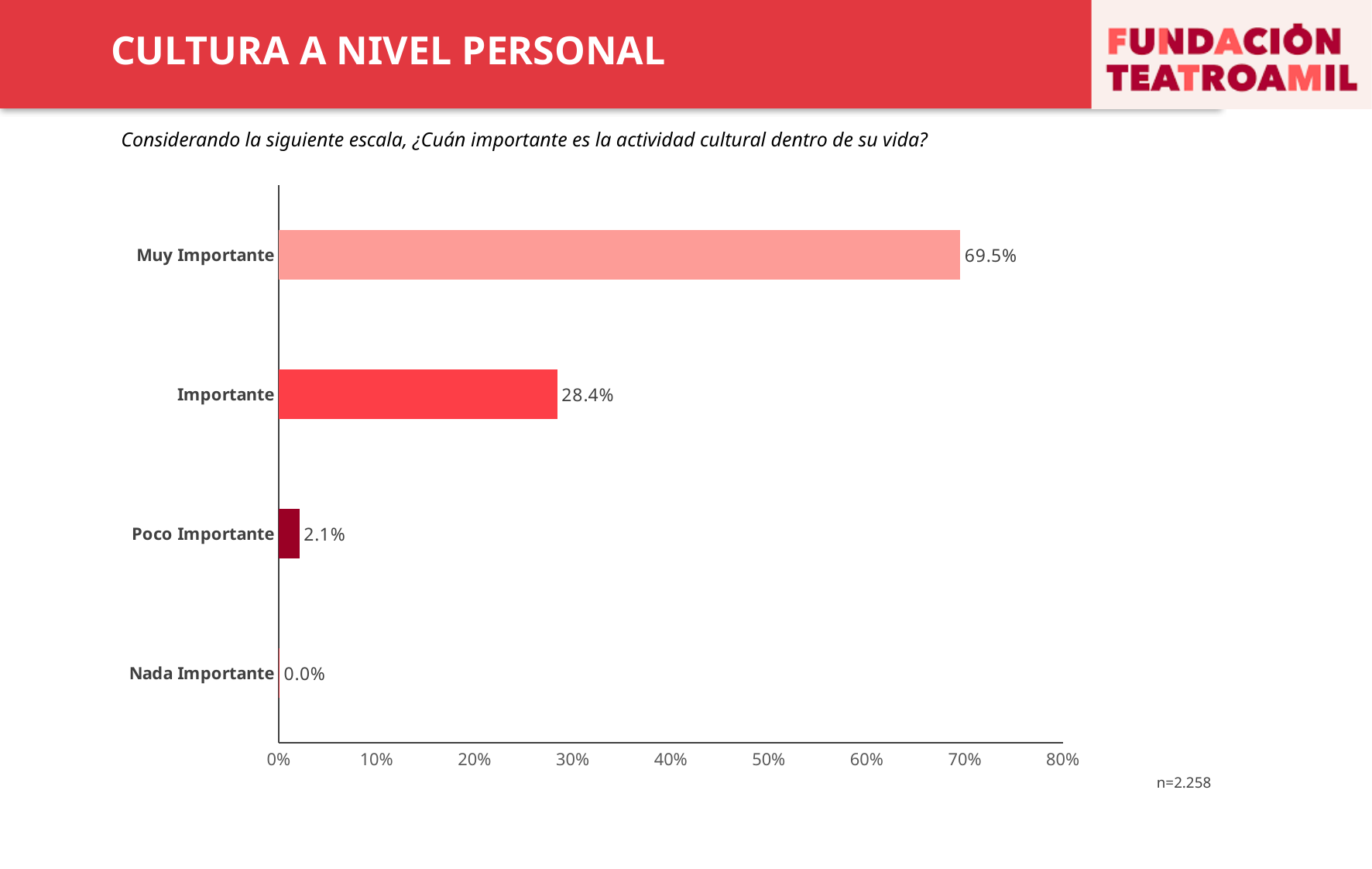
What type of chart is shown on the slide? Bar chart What is the sample size (n) noted below the chart? n=2.258 How many categories are shown in the chart? 4 What is the value shown for "Nada Importante"? 0.0% What percentage of respondents answered "Muy Importante"? 69.5% What is the value shown for "Importante"? 28.4% Which is larger, the value for "Importante" or the value for "Poco Importante"? Importante What is the difference between the values for "Muy Importante" and "Importante"? 41.1% What is the value shown for "Poco Importante"? 2.1% Which category has the highest value? Muy Importante Which category has the lowest value? Nada Importante Is the value for "Muy Importante" greater or less than 60%? greater